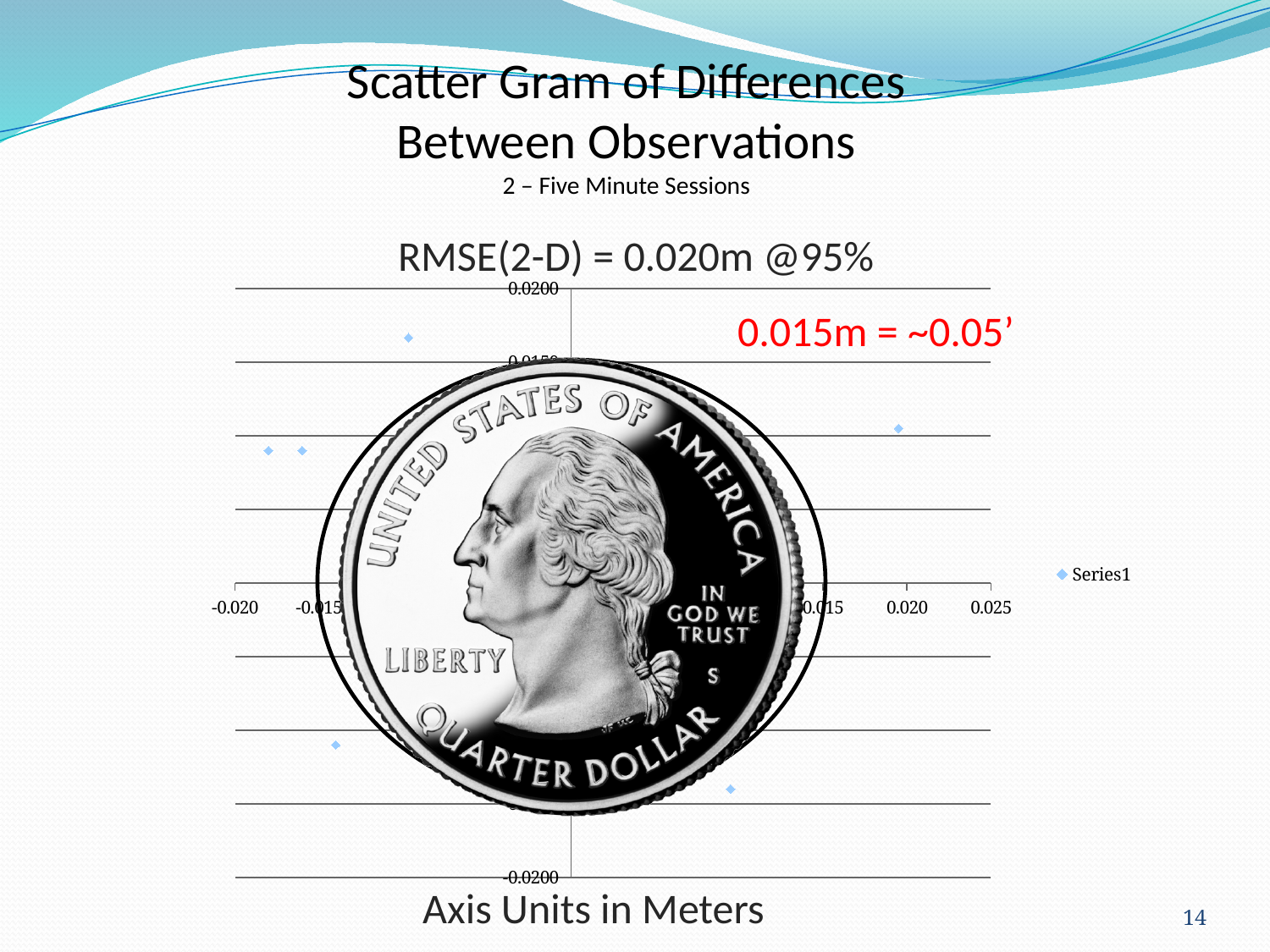
What is the highest value labelled on the chart's vertical axis? 0.0200 What is the lowest value labelled on the chart's vertical axis? -0.0200 Is the horizontal value of the rightmost visible data point greater or less than 0.015? greater Is the vertical value of the highest visible data point greater or less than 0.0150? greater What is the smallest value labelled on the chart's horizontal axis? -0.020 How many series does the chart legend list? 1 What is the title of the chart? RMSE(2-D) = 0.020m @95% What kind of chart is shown on the slide? scatter chart What is the name of the series shown in the chart legend? Series1 What is the largest value labelled on the chart's horizontal axis? 0.025